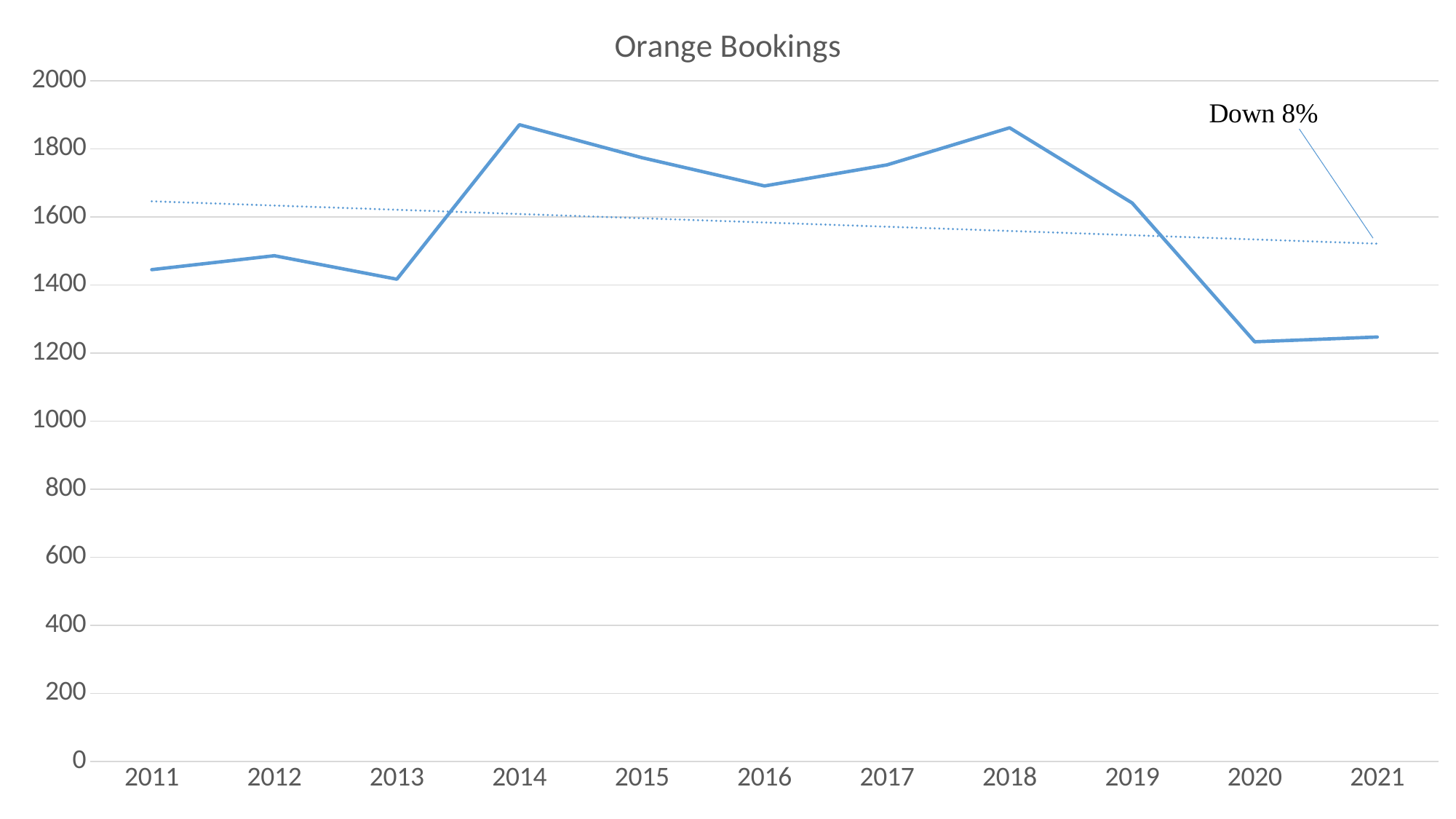
What is the title of the chart? Orange Bookings Do the values rise or fall from 2018 to 2020? fall Do the values rise or fall from 2013 to 2014? rise Is the value for 2020 greater or less than 1400? less What kind of chart is shown on the slide? line chart How many years are plotted along the x axis? 11 What does the text annotation near the end of the dotted trendline say? Down 8% Which year has the larger value, 2013 or 2014? 2014 Is the value for 2014 greater or less than 1800? greater Is the value for 2016 greater or less than 1800? less Which year has the larger value, 2018 or 2020? 2018